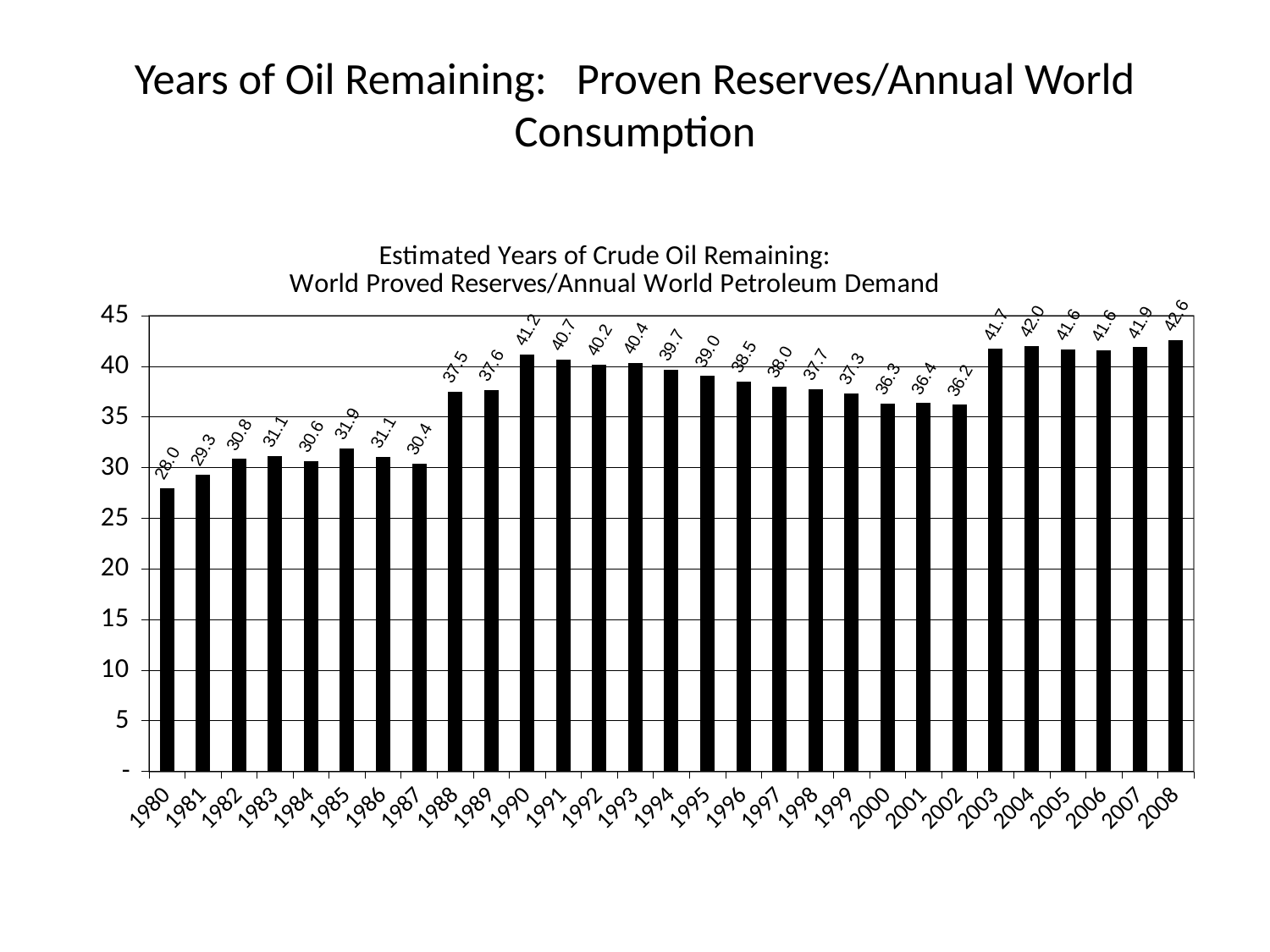
Which is larger, the value for 1985 or the value for 1984? 1985 What is the value for 1980? 28.0 What kind of chart is shown? bar chart What is the difference between the values for 1988 and 1987? 7.1 Is the value for 1999 greater or less than 35? greater Which year has the lowest value? 1980 What is the value for 2002? 36.2 How many years are plotted on the chart? 29 Which year has the highest value? 2008 What is the value for 2008? 42.6 What is the value for 1990? 41.2 What is the title printed above the chart's plot area? Estimated Years of Crude Oil Remaining: World Proved Reserves/Annual World Petroleum Demand